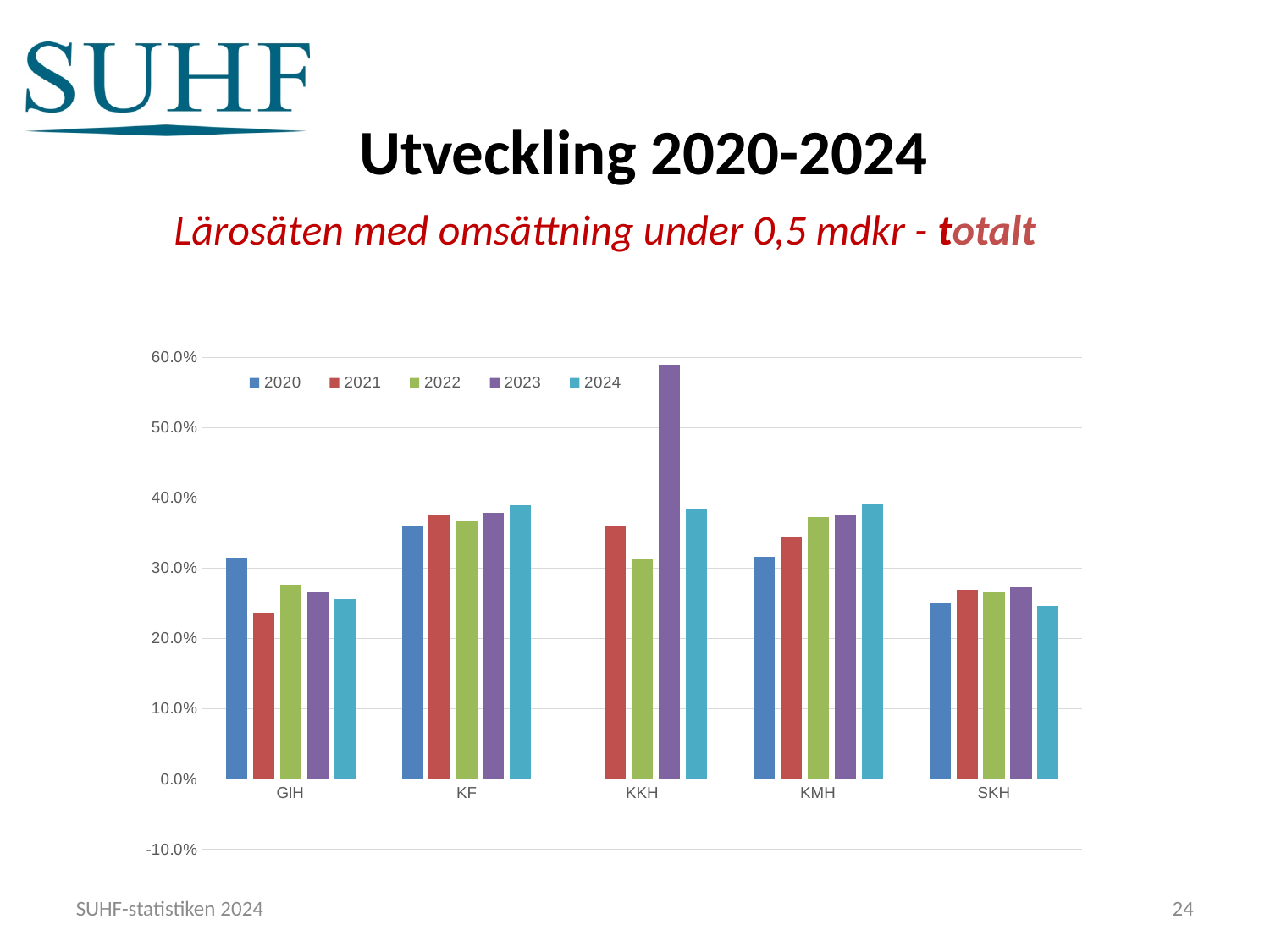
How many categories are shown on the x axis? 5 Which category has the highest 2020 value? KF Is the value for KF in 2024 greater or less than 40.0%? less What kind of chart is shown on the slide? bar chart Which category has the highest bar in the chart? KKH How many series does the legend list? 5 Which is larger for GIH, the 2020 value or the 2021 value? 2020 Which years are listed in the chart legend? 2020, 2021, 2022, 2023, 2024 Which category has the lowest 2021 value? GIH Is the value for GIH in 2021 greater or less than 30.0%? less Is the value for SKH in 2020 greater or less than 20.0%? greater